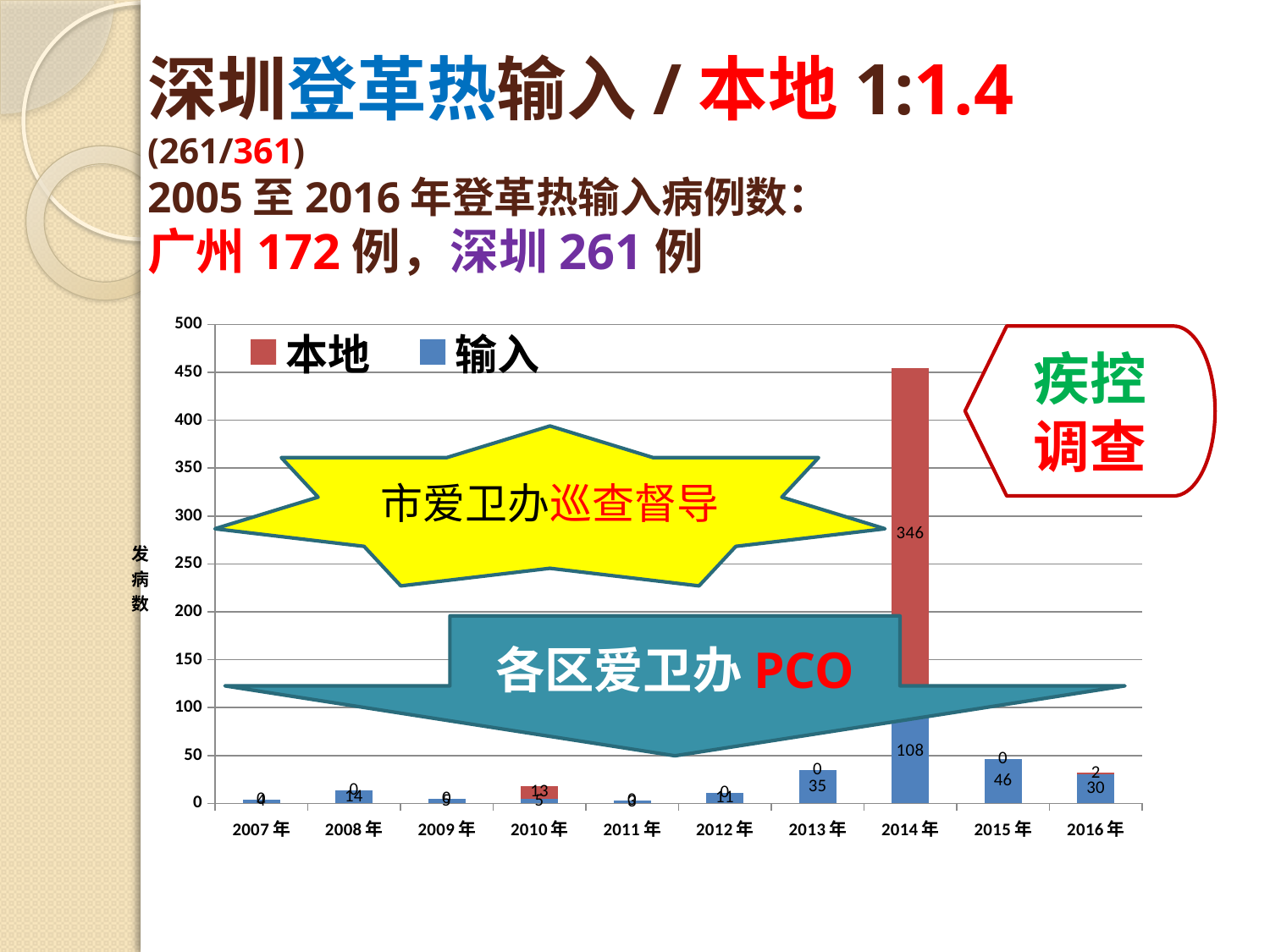
What is the total height of the stacked bar for 2014年 (本地 plus 输入)? 454 What is the value of the 本地 series for 2016年? 2 What is the difference between the 输入 values for 2015年 and 2013年? 11 What is the value of the 输入 series for 2013年? 35 How many series does the legend list? 2 What is the value of the 本地 series for 2014年? 346 Which year has the highest total number of cases? 2014年 What is the value of the 本地 series for 2010年? 13 In 2014年, which series is larger, 本地 or 输入? 本地 How many years are shown on the x axis? 10 What is the value of the 输入 series for 2014年? 108 What is the value of the 输入 series for 2015年? 46